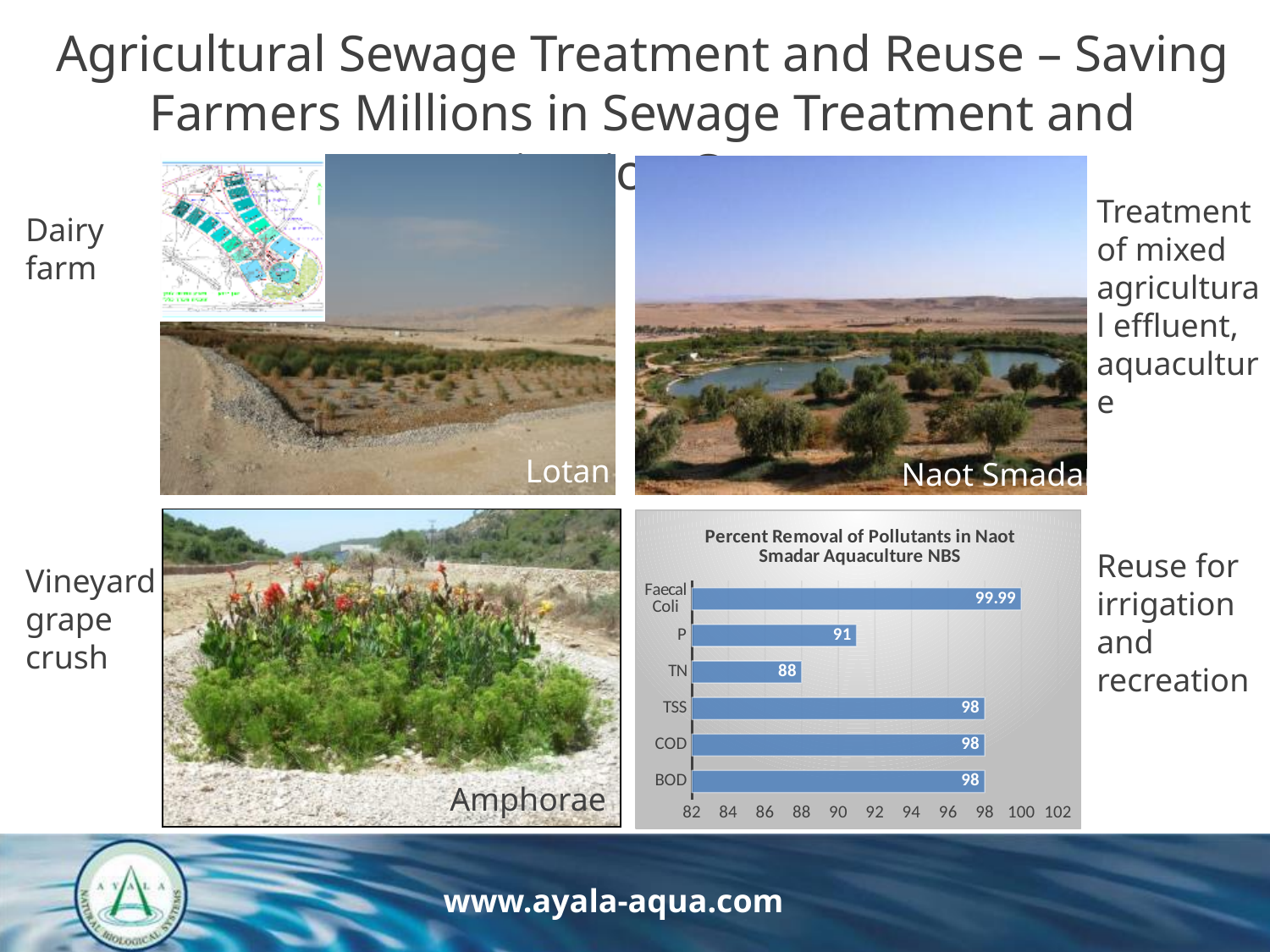
What is the percent removal of Faecal Coli in the Naot Smadar aquaculture NBS chart? 99.99 Which has a higher percent removal, P or COD? COD What is the percent removal of TN shown in the chart? 88 What is the title of the chart on the slide? Percent Removal of Pollutants in Naot Smadar Aquaculture NBS What is the percent removal of P shown in the chart? 91 How many pollutants are shown in the chart? 6 What kind of chart is used to show percent removal of pollutants? bar chart Is the percent removal of TN greater or less than 90? less Which pollutant has the lowest percent removal in the chart? TN Which pollutant has the highest percent removal in the chart? Faecal Coli What is the difference between the percent removal of P and TN? 3 What is the percent removal of TSS shown in the chart? 98